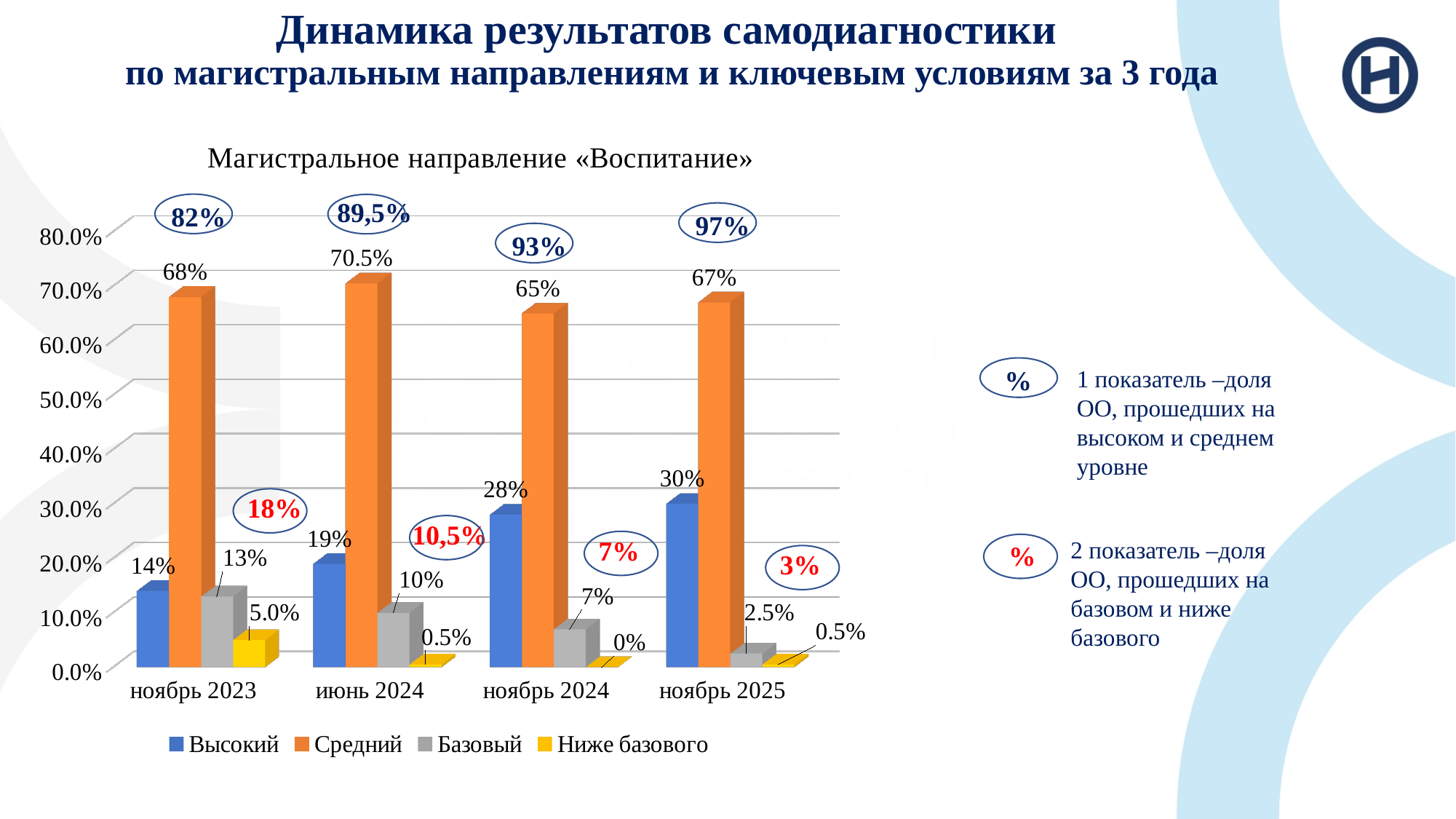
In which period is the Базовый value lowest? ноябрь 2025 How many periods are shown on the x axis? 4 What is the difference between the Высокий values for ноябрь 2024 and ноябрь 2023? 14% What is the value for Высокий in ноябрь 2025? 30% Which is larger: the Средний value for ноябрь 2023 or for ноябрь 2025? ноябрь 2023 What is the value for Базовый in ноябрь 2023? 13% How many series does the legend list? 4 What is the value for Ниже базового in ноябрь 2024? 0% What kind of chart is shown? bar chart In which period is the Высокий value highest? ноябрь 2025 Does the Высокий value rise or fall from ноябрь 2023 to ноябрь 2025? rise What is the value for Средний in июнь 2024? 70.5%